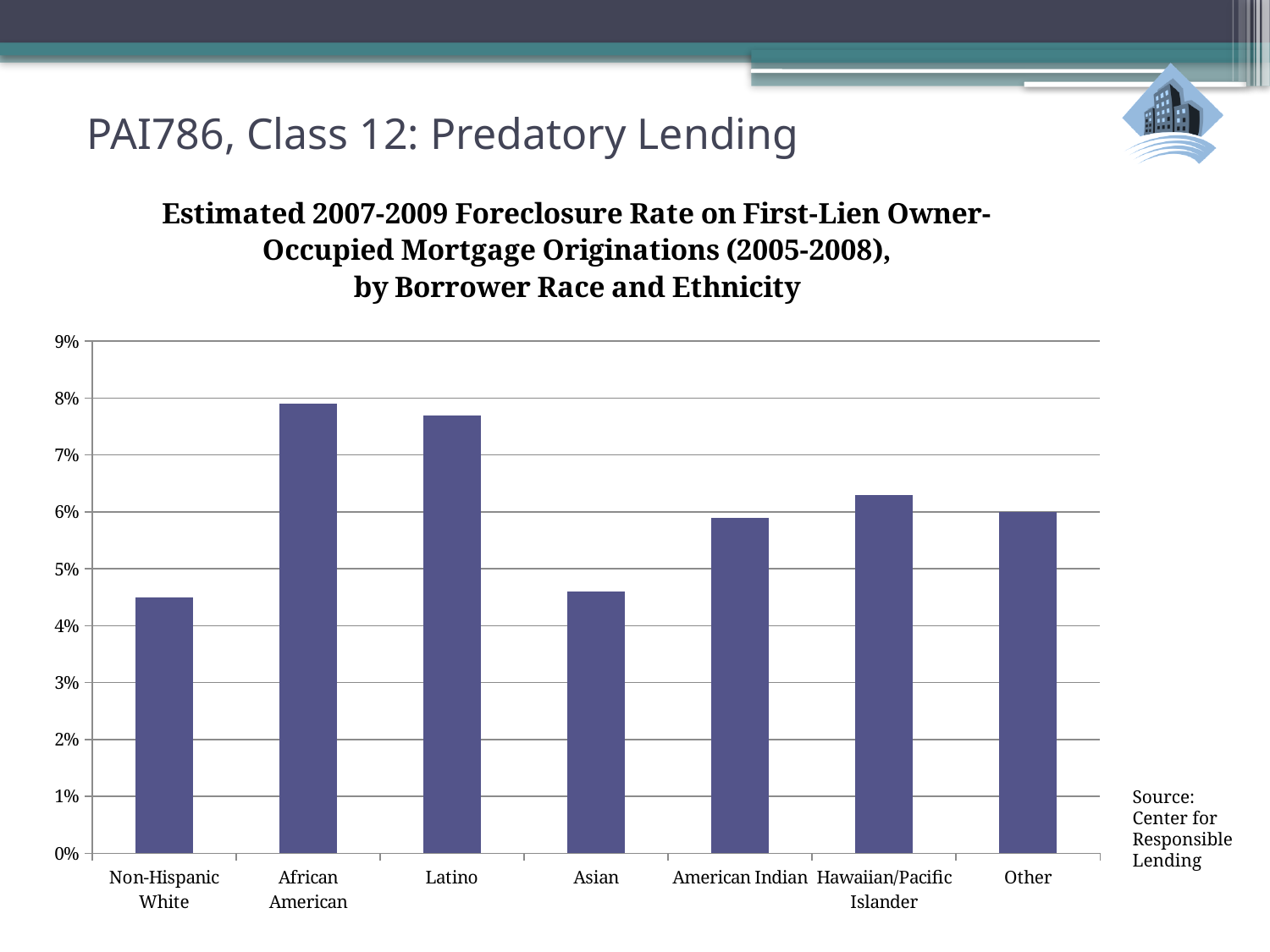
Which has a higher foreclosure rate, Hawaiian/Pacific Islander or American Indian borrowers? Hawaiian/Pacific Islander Which has a higher foreclosure rate, African American or Asian borrowers? African American Is the foreclosure rate for Non-Hispanic White borrowers greater or less than 5%? less Is the foreclosure rate for Hawaiian/Pacific Islander borrowers greater or less than 6%? greater Is the foreclosure rate for African American borrowers greater or less than 7%? greater What kind of chart is shown on the slide? bar chart Which borrower group has the highest estimated foreclosure rate? African American How many borrower race and ethnicity categories are shown on the x axis? 7 What source is cited for the chart's data? Center for Responsible Lending